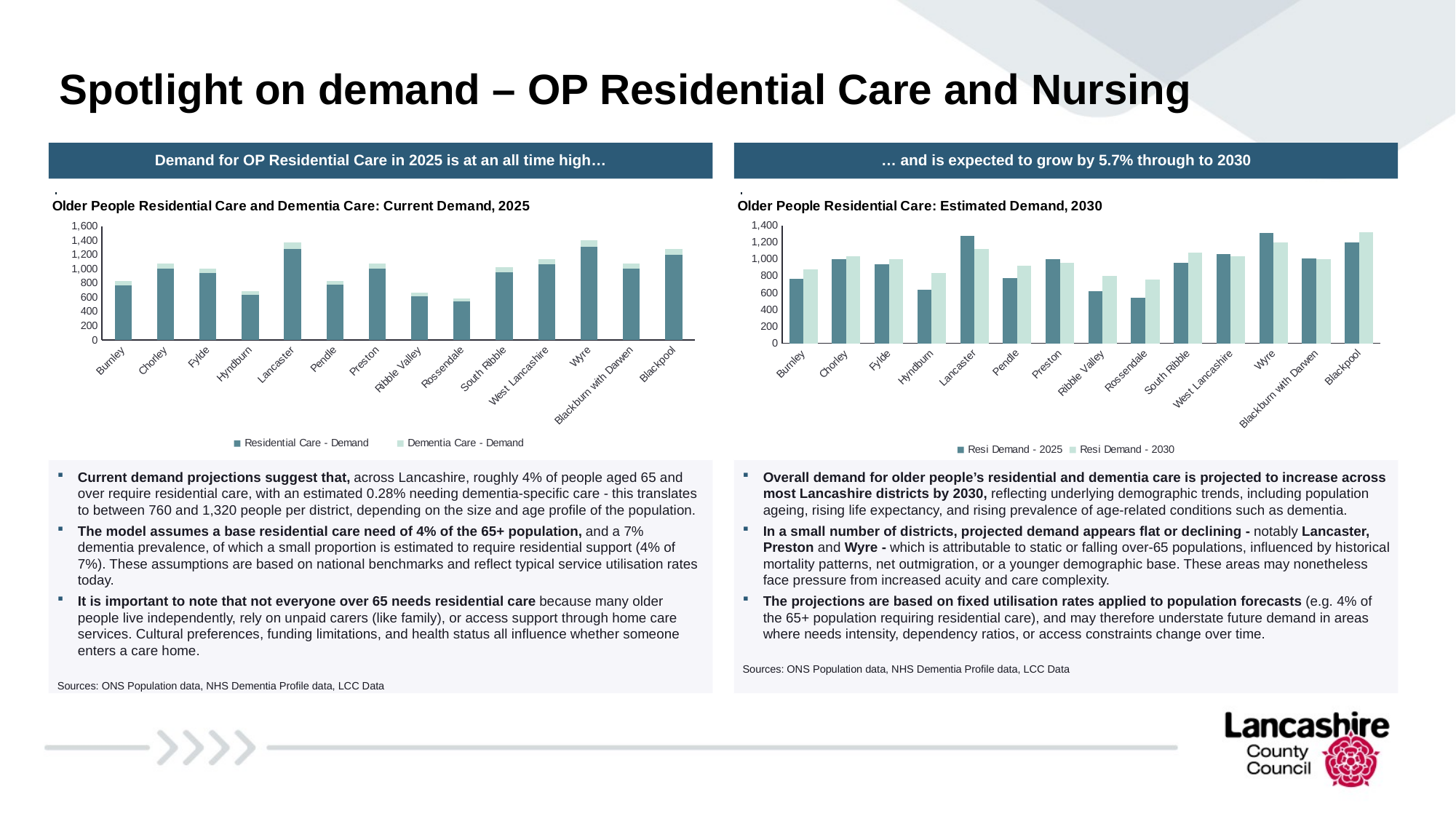
How many series does the legend of the left chart, 'Older People Residential Care and Dementia Care: Current Demand, 2025', list? 2 What are the two legend entries of the right chart, 'Older People Residential Care: Estimated Demand, 2030'? Resi Demand - 2025 and Resi Demand - 2030 In the right chart, 'Older People Residential Care: Estimated Demand, 2030', which district has the lowest Resi Demand - 2030 value? Rossendale In the left chart, 'Older People Residential Care and Dementia Care: Current Demand, 2025', is the Residential Care - Demand value for Rossendale greater or less than 600? less In the left chart, 'Older People Residential Care and Dementia Care: Current Demand, 2025', which district has the lowest total demand? Rossendale How many districts are shown on the x axis of the left chart, 'Older People Residential Care and Dementia Care: Current Demand, 2025'? 14 In the right chart, 'Older People Residential Care: Estimated Demand, 2030', which district has the highest Resi Demand - 2030 value? Blackpool In the right chart, 'Older People Residential Care: Estimated Demand, 2030', is the Resi Demand - 2030 value for Wyre greater or less than 1,000? greater What kind of chart is the left chart, 'Older People Residential Care and Dementia Care: Current Demand, 2025'? Bar chart In the right chart, 'Older People Residential Care: Estimated Demand, 2030', is the Resi Demand - 2025 value for Lancaster larger or smaller than its Resi Demand - 2030 value? larger In the left chart, 'Older People Residential Care and Dementia Care: Current Demand, 2025', is the Residential Care - Demand value for Lancaster greater or less than 1,200? greater